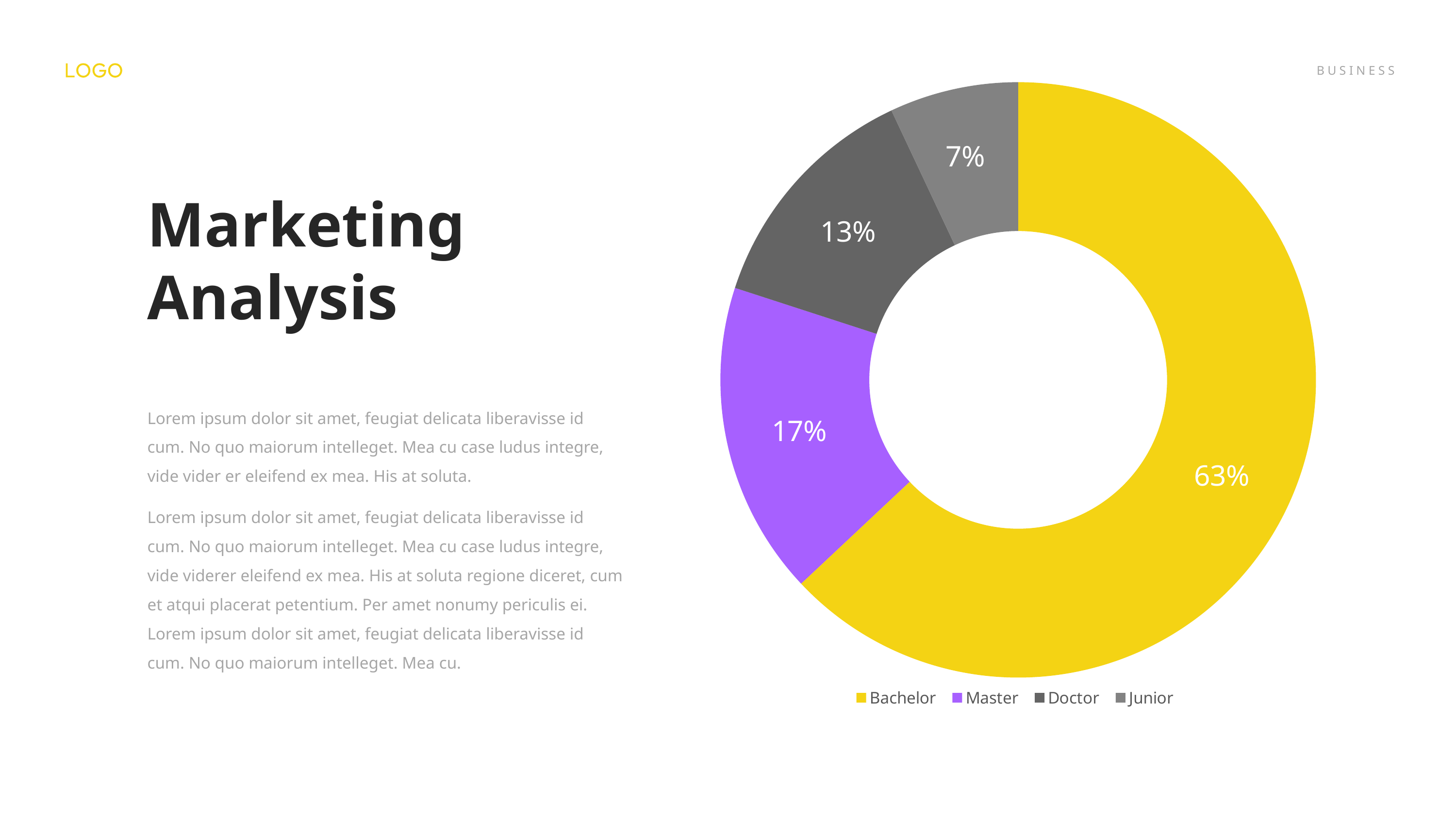
What is the difference in percentage points between the Doctor and Junior slices? 6 What share of the doughnut chart does Bachelor represent? 63% What share of the doughnut chart does Doctor represent? 13% What share of the doughnut chart does Master represent? 17% How many categories does the chart show? 4 Which category has the largest slice in the chart? Bachelor What share of the doughnut chart does Junior represent? 7% What kind of chart is shown on the slide? Doughnut chart What colour is the Master slice in the chart? Purple What is the difference in percentage points between the Bachelor and Master slices? 46 Which slice is larger, Master or Doctor? Master Which category has the smallest slice in the chart? Junior